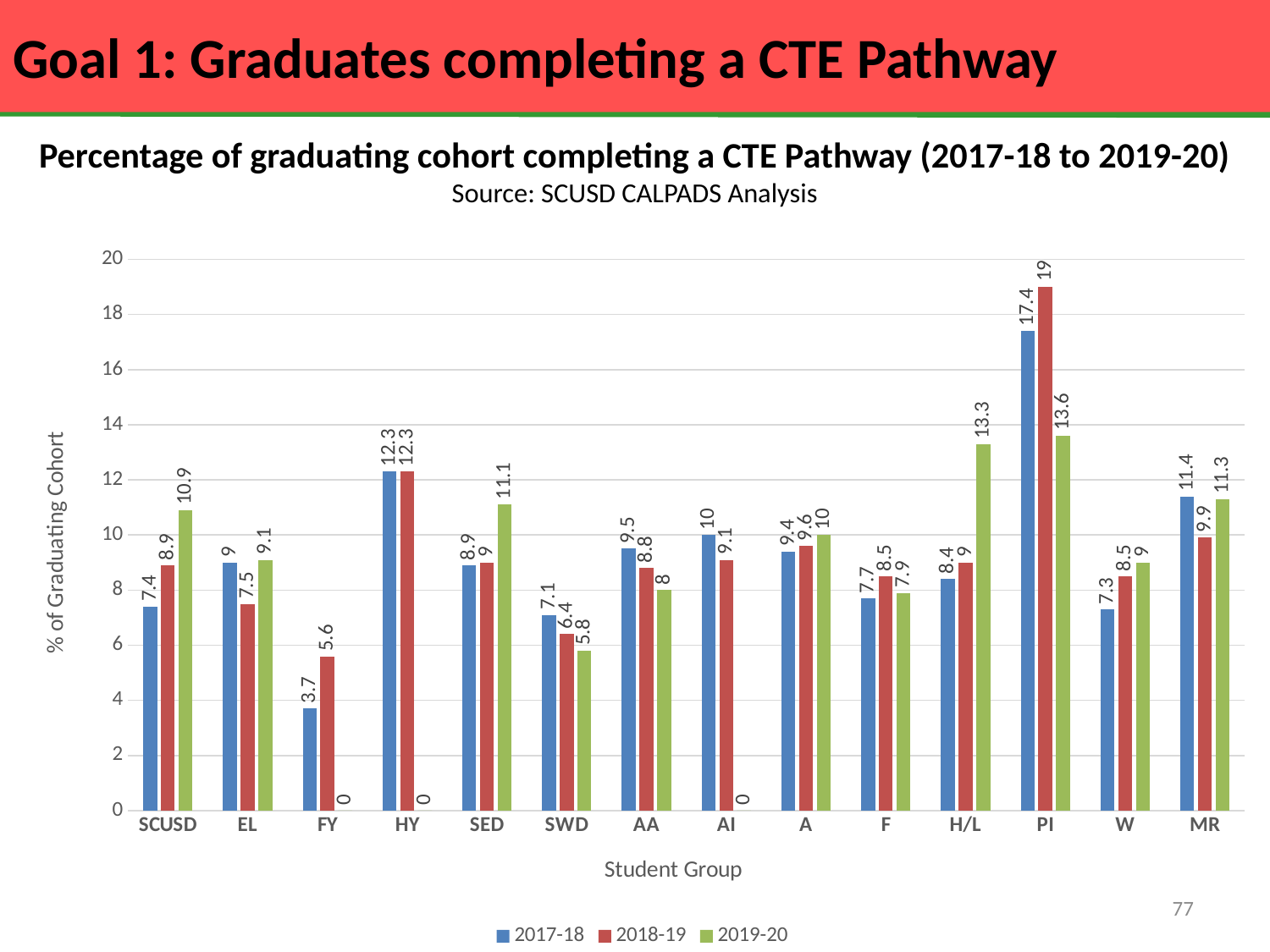
Which student group has the lowest 2017-18 value? FY How many student groups are shown on the x axis? 14 Which is larger for MR: the 2017-18 value or the 2018-19 value? 2017-18 Which student group has the highest 2018-19 value? PI Do the values for SWD rise or fall from 2017-18 to 2019-20? fall How many series does the legend list? 3 What kind of chart is shown on the slide? bar chart What is the 2019-20 value for SCUSD? 10.9 What is the difference between the 2019-20 and 2017-18 values for H/L? 4.9 What is the 2018-19 value for FY? 5.6 Is the 2019-20 value for PI greater or less than 12? greater What is the 2017-18 value for PI? 17.4